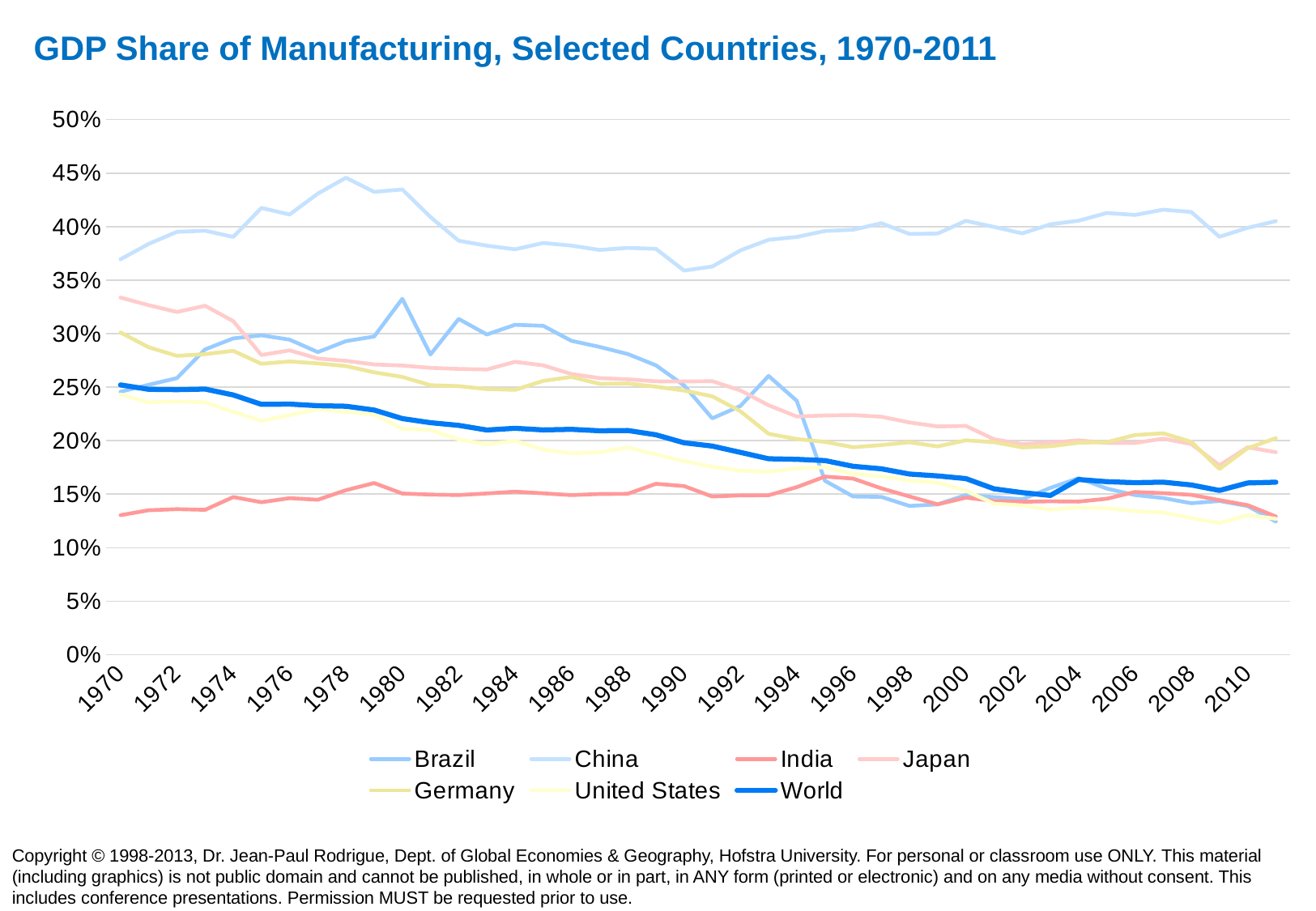
What kind of chart is shown on the slide? line chart In 1980, which is larger: the value for Brazil or the value for Germany? Brazil Is the value for China in 1978 greater or less than 40%? greater Does the Japan line rise or fall from 1970 to 2011? fall Is the value for India in 1970 greater or less than 15%? less Is the value for World in 2010 greater or less than 20%? less What is the title of the chart? GDP Share of Manufacturing, Selected Countries, 1970-2011 Which series has the lowest value in 1970? India Does the World line rise or fall from 1970 to 2011? fall How many series does the legend list? 7 In 1970, which is larger: the value for Japan or the value for Brazil? Japan Which country has the highest GDP share of manufacturing in 2010? China